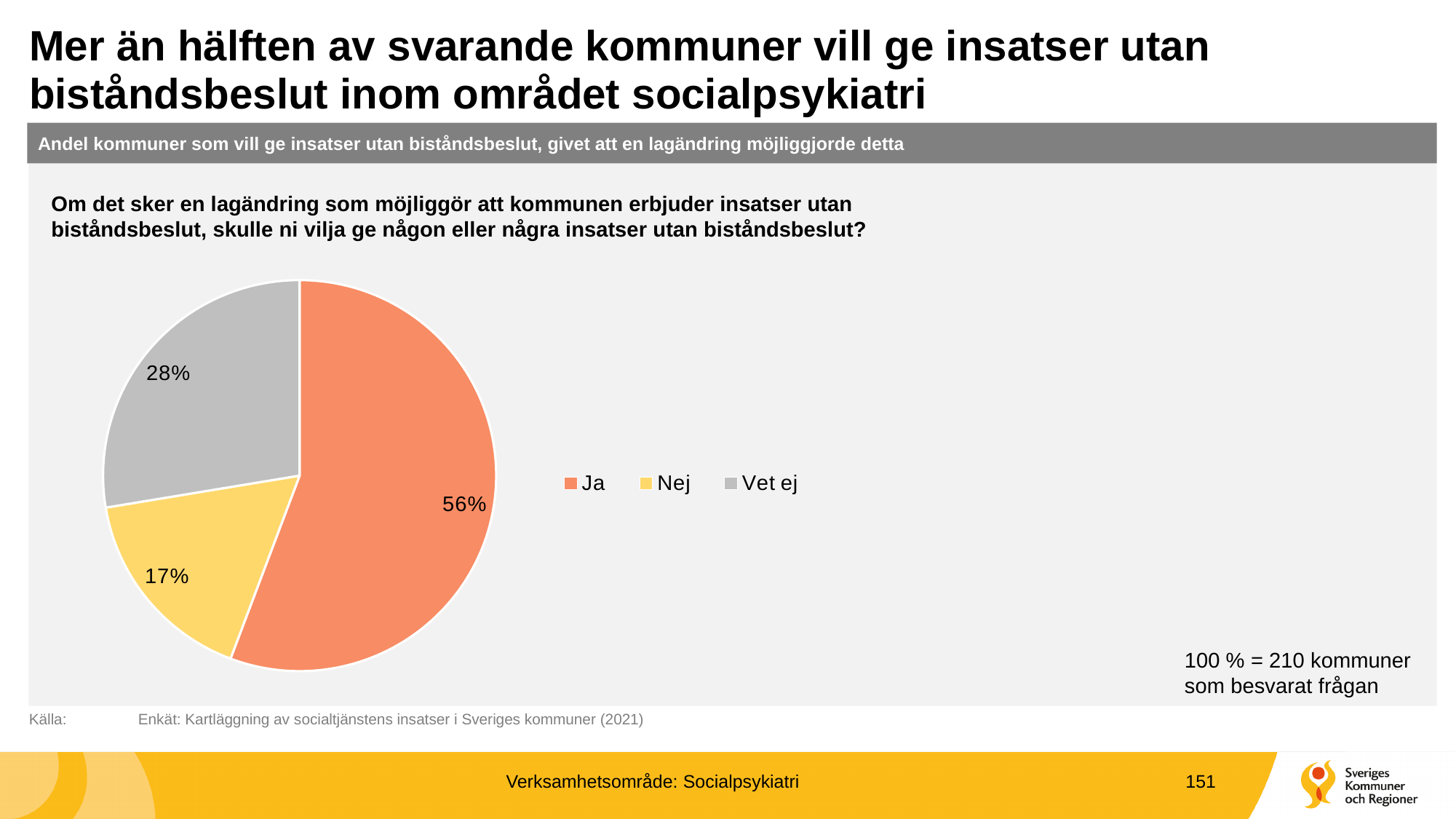
Which slice of the pie is the smallest? Nej What is the difference in percentage points between the "Vet ej" slice and the "Nej" slice? 11 What share of the pie is labelled "Nej"? 17% What kind of chart is shown on the slide? pie chart Which slice of the pie is the largest? Ja Which is larger, the "Nej" slice or the "Vet ej" slice? Vet ej What is the difference in percentage points between the "Ja" slice and the "Vet ej" slice? 28 What colour is the "Ja" slice in the pie chart? orange How many entries does the legend list? 3 How many slices does the pie chart have? 3 What share of the pie is labelled "Vet ej"? 28% What share of the pie is labelled "Ja"? 56%